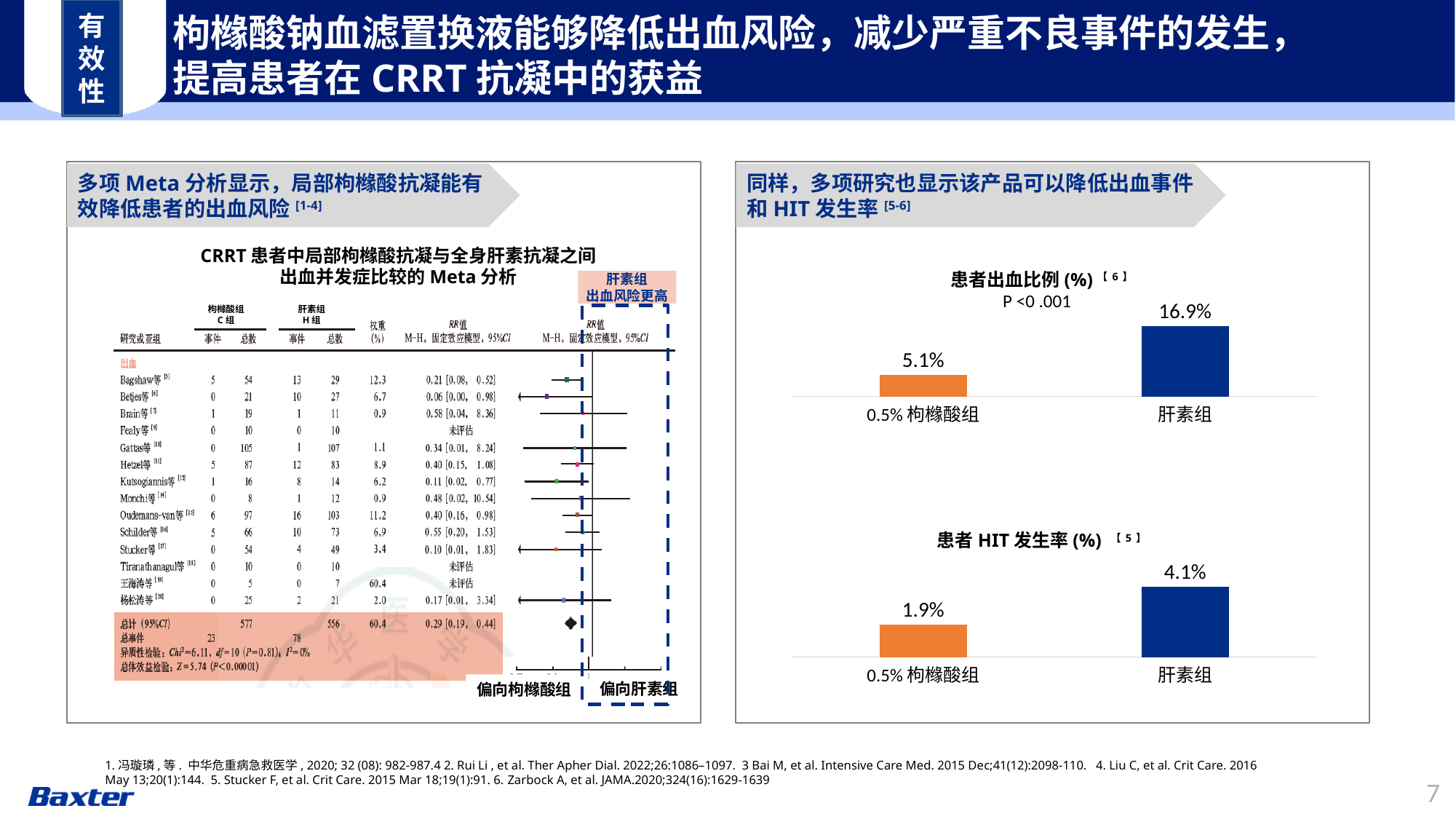
In the 患者出血比例 (%) chart, what is the value for 肝素组? 16.9% In the 患者 HIT 发生率 (%) chart, what is the value for 0.5% 枸橼酸组? 1.9% In the 患者出血比例 (%) chart, what P value is shown? P <0 .001 In the 患者出血比例 (%) chart, what is the difference between 肝素组 and 0.5% 枸橼酸组? 11.8% In the 患者 HIT 发生率 (%) chart, which group has the lower HIT rate? 0.5% 枸橼酸组 What kind of chart is the 患者 HIT 发生率 (%) chart? Bar chart How many categories are shown in the 患者出血比例 (%) chart? 2 In the 患者出血比例 (%) chart, what colour is the bar for 肝素组? Dark blue In the 患者 HIT 发生率 (%) chart, what is the difference between 肝素组 and 0.5% 枸橼酸组? 2.2% In the 患者出血比例 (%) chart, which group has the higher bleeding proportion? 肝素组 In the 患者出血比例 (%) chart, what is the value for 0.5% 枸橼酸组? 5.1% In the 患者 HIT 发生率 (%) chart, what is the value for 肝素组? 4.1%